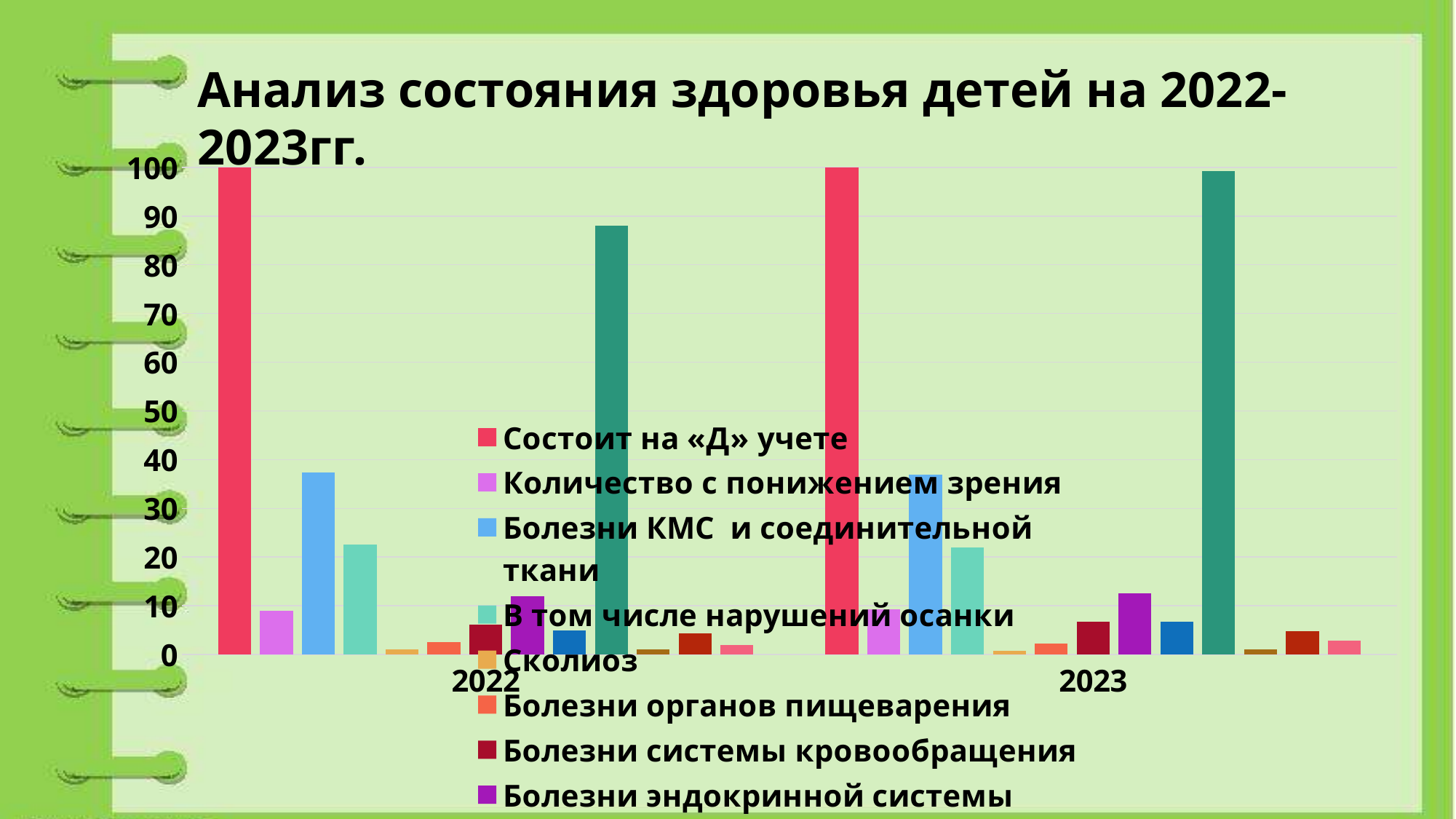
Is the value for «Количество с понижением зрения» in 2022 greater or less than 10? less What is the title of the chart? Анализ состояния здоровья детей на 2022-2023гг. In 2022, which is larger: «Болезни КМС и соединительной ткани» or «В том числе нарушений осанки»? Болезни КМС и соединительной ткани What is the value for «Состоит на «Д» учете» in 2022? 100 Which years are shown on the x axis? 2022 and 2023 What kind of chart is shown on the slide? bar chart Is the value for «Болезни эндокринной системы» in 2023 greater or less than 10? greater Is the value for «Болезни КМС и соединительной ткани» in 2022 greater or less than 30? greater How many year categories are shown on the x axis? 2 Which series has the highest value in 2022? Состоит на «Д» учете